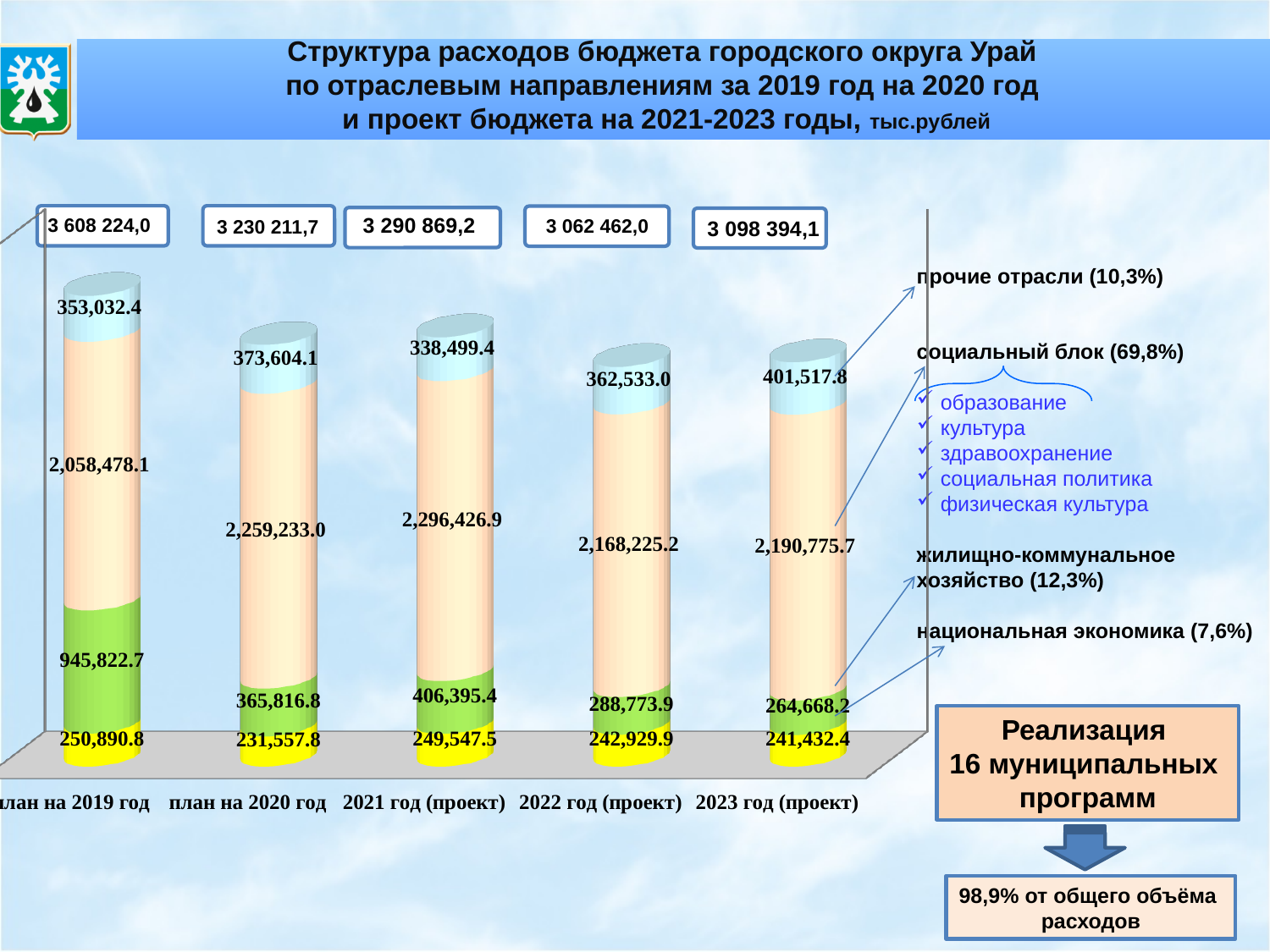
How many budget periods (bars) are shown on the chart? 5 What is the value of the национальная экономика segment for 2022 год (проект)? 242,929.9 What is the difference between the жилищно-коммунальное хозяйство values for план на 2019 год and план на 2020 год? 580,005.9 What is the total expenditure shown above the bar for 2022 год (проект)? 3 062 462,0 Which period has the largest социальный блок segment? 2021 год (проект) What type of chart is shown on the slide? stacked bar chart What share of total expenditure does the социальный блок account for, according to the label on the right? 69,8% Which is larger: the прочие отрасли value for план на 2020 год or for 2021 год (проект)? план на 2020 год What is the value of the жилищно-коммунальное хозяйство segment for план на 2019 год? 945,822.7 What is the value of the социальный блок segment for план на 2020 год? 2,259,233.0 What is the value of the прочие отрасли segment for 2023 год (проект)? 401,517.8 Which period has the smallest национальная экономика segment? план на 2020 год